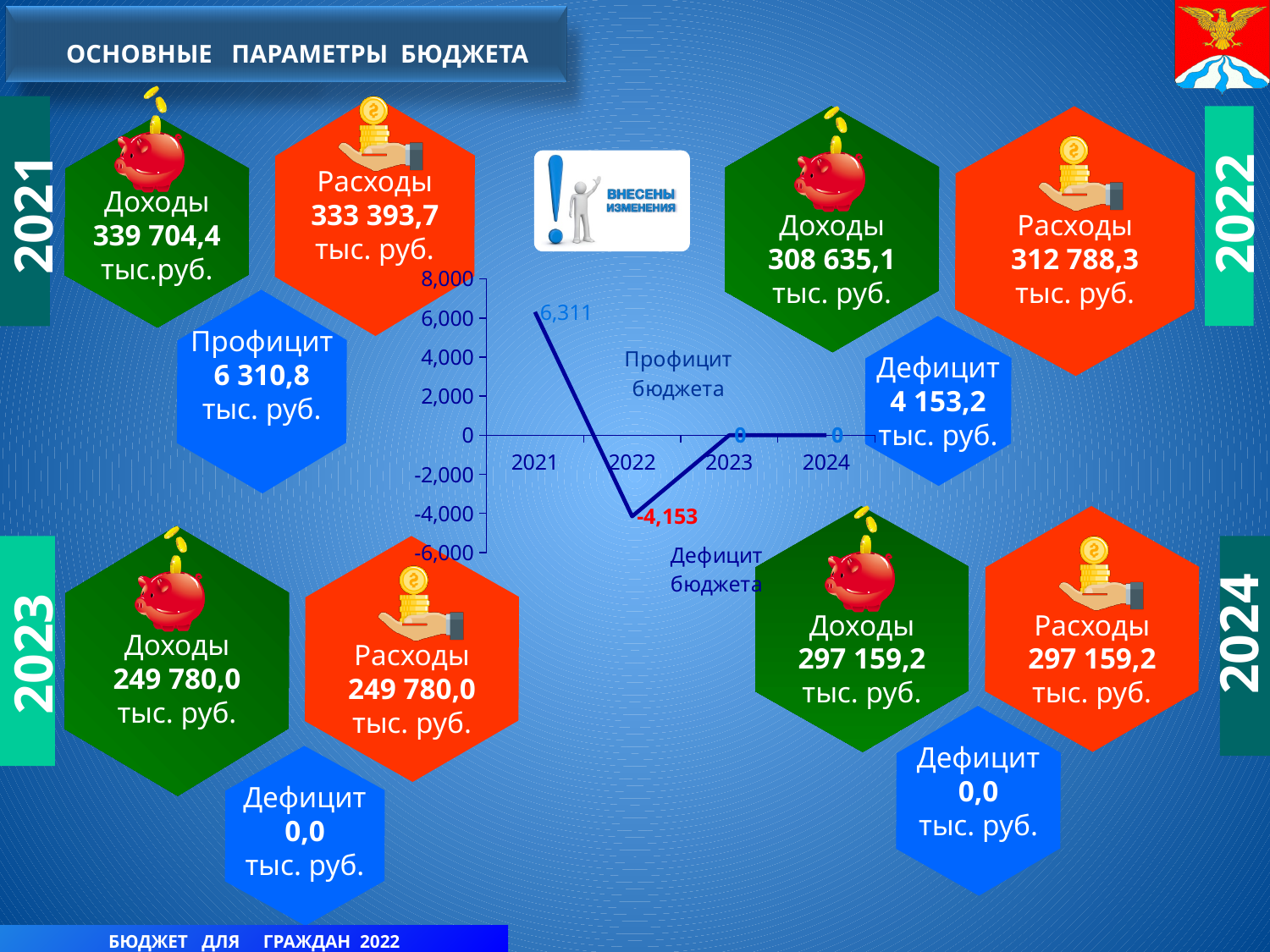
Is the value for 2021 on the line chart greater or less than 4,000? greater Which year has the lowest value on the line chart? 2022 Which year has the highest value on the line chart? 2021 How many years are plotted on the x axis of the line chart? 4 What is the value plotted for 2024 on the line chart? 0 What is the value plotted for 2023 on the line chart? 0 Does the line on the chart rise or fall from 2021 to 2022? fall Which is larger on the line chart, the value for 2021 or the value for 2022? 2021 What is the value plotted for 2021 on the line chart? 6,311 What is the highest tick value shown on the vertical axis of the line chart? 8,000 What kind of chart is shown in the centre of the slide? line chart What is the value plotted for 2022 on the line chart? -4,153